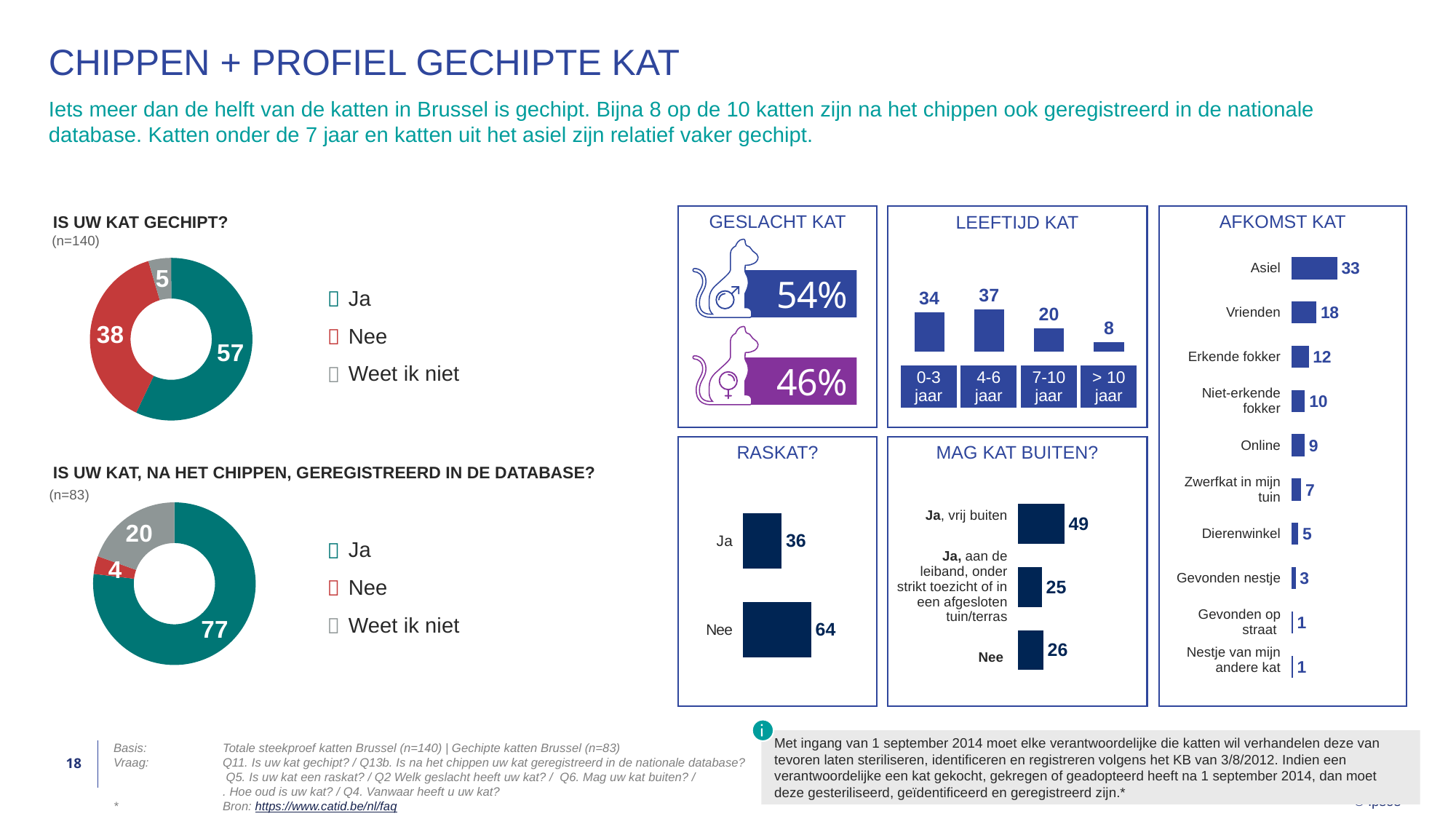
In the 'LEEFTIJD KAT' chart, which age group has the highest value? 4-6 jaar In the 'GESLACHT KAT' panel, what is the percentage shown for the male cat? 54% In the 'RASKAT?' chart, what is the difference between 'Nee' and 'Ja'? 28 In the 'AFKOMST KAT' chart, what is the value for 'Vrienden'? 18 In the 'IS UW KAT, NA HET CHIPPEN, GEREGISTREERD IN DE DATABASE?' donut chart, what is the difference between 'Ja' and 'Weet ik niet'? 57 In the 'IS UW KAT, NA HET CHIPPEN, GEREGISTREERD IN DE DATABASE?' donut chart, what is the value for 'Nee'? 4 In the 'IS UW KAT GECHIPT?' donut chart, what is the value for 'Weet ik niet'? 5 In the 'MAG KAT BUITEN?' chart, which is larger: 'Ja, vrij buiten' or 'Nee'? Ja, vrij buiten In the 'LEEFTIJD KAT' chart, what is the value for '> 10 jaar'? 8 In the 'AFKOMST KAT' chart, which category has the highest value? Asiel In the 'IS UW KAT GECHIPT?' donut chart, what is the value for 'Ja'? 57 How many categories are shown in the 'AFKOMST KAT' chart? 10